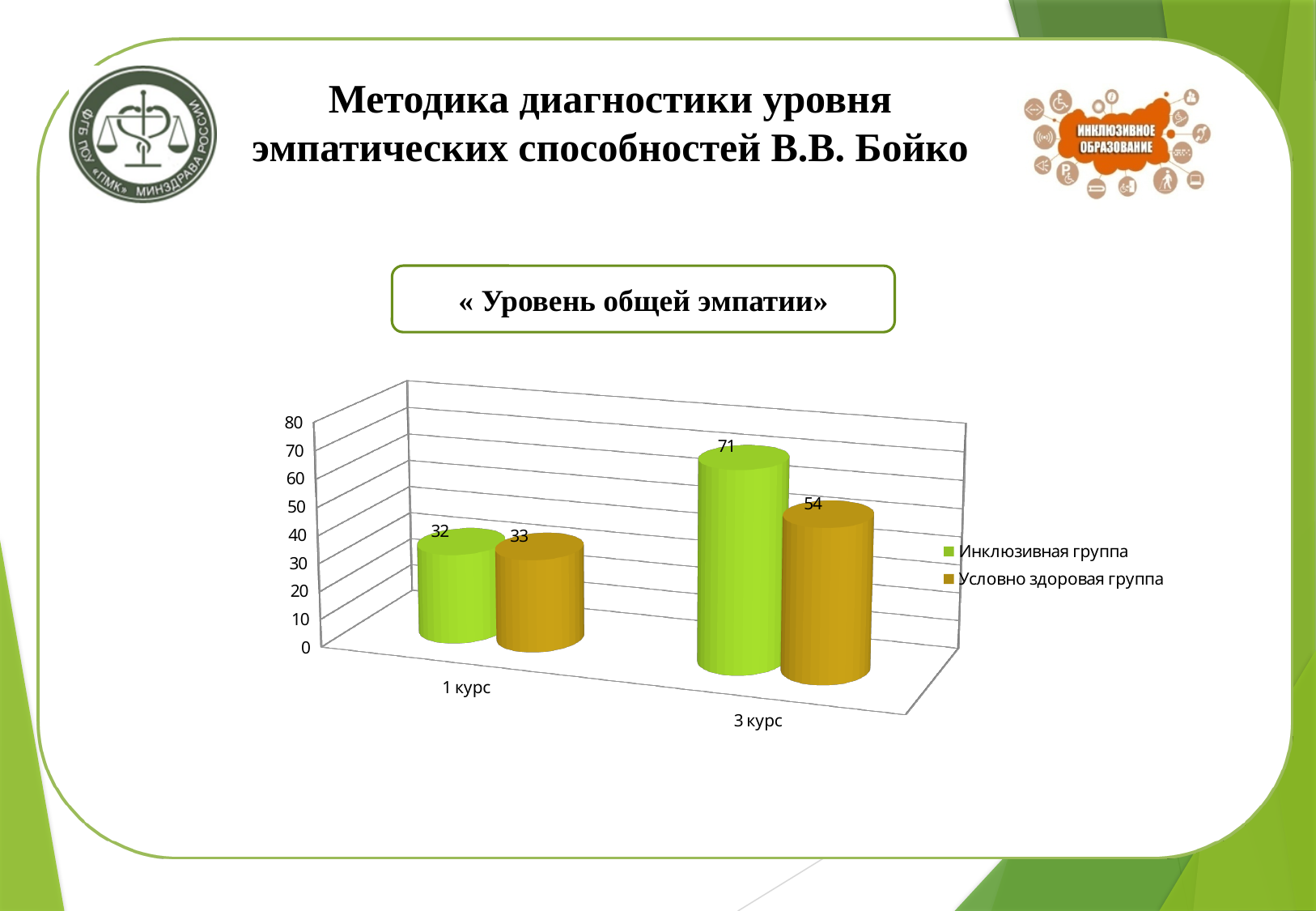
How many series does the legend list? 2 What kind of chart is shown on the slide? Bar chart What is the difference between Инклюзивная группа and Условно здоровая группа at 3 курс? 17 What is the value for Условно здоровая группа at 3 курс? 54 Which category has the lowest value for Условно здоровая группа? 1 курс Do the values for Инклюзивная группа rise or fall from 1 курс to 3 курс? Rise At 3 курс, which series has the larger value: Инклюзивная группа or Условно здоровая группа? Инклюзивная группа What is the value for Инклюзивная группа at 3 курс? 71 How many categories are shown on the x axis? 2 What is the value for Условно здоровая группа at 1 курс? 33 Which category has the highest value for Инклюзивная группа? 3 курс What is the value for Инклюзивная группа at 1 курс? 32